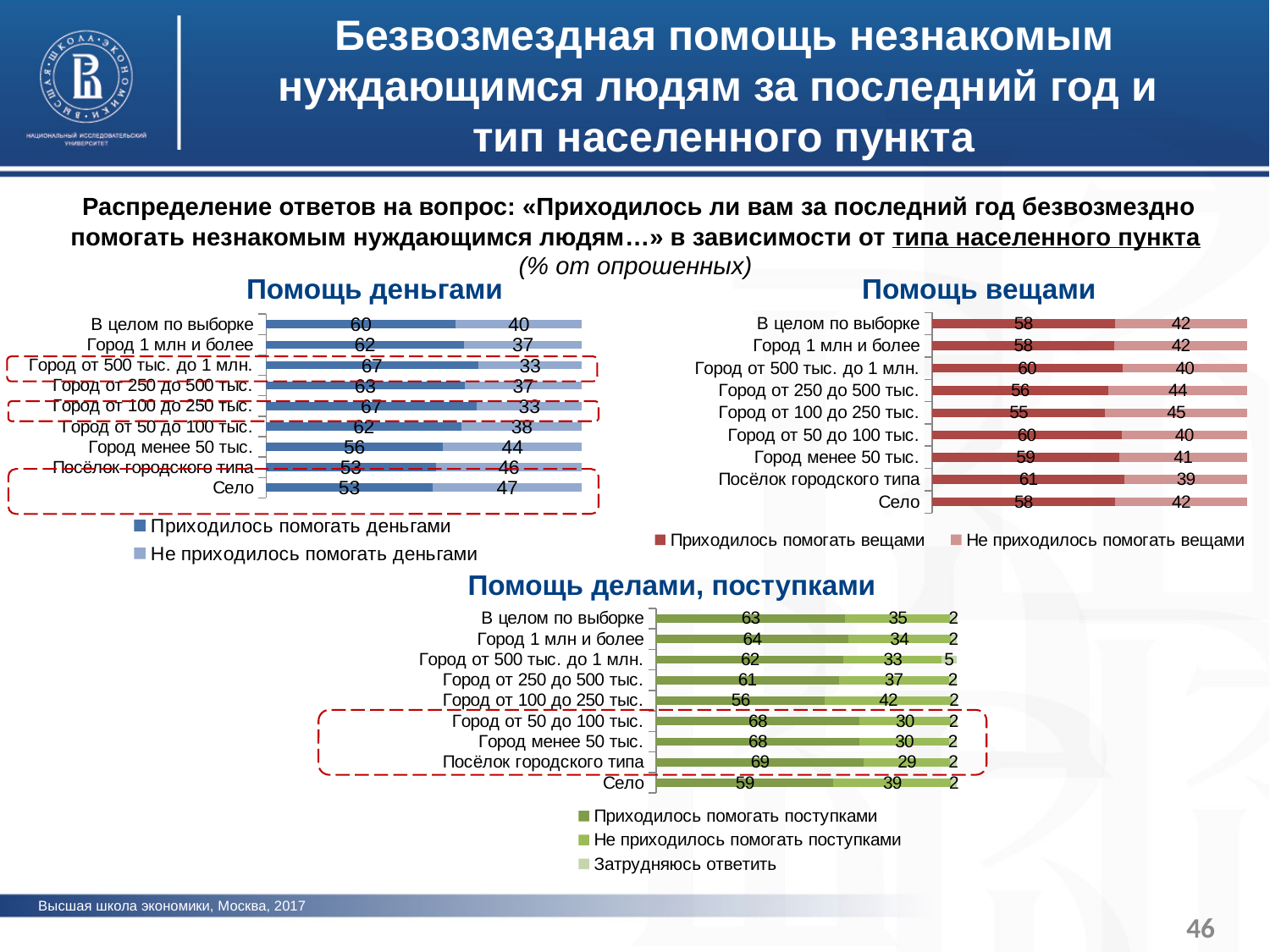
How many series does the legend of the 'Помощь делами, поступками' chart list? 3 In the 'Помощь вещами' chart, what colour represents 'Приходилось помогать вещами'? Dark red What type of chart is the 'Помощь деньгами' chart? Stacked bar chart In the 'Помощь деньгами' chart, which has the larger value for 'Приходилось помогать деньгами': 'Город менее 50 тыс.' or 'Город от 250 до 500 тыс.'? Город от 250 до 500 тыс. In the 'Помощь делами, поступками' chart, which category has the highest value for 'Приходилось помогать поступками'? Посёлок городского типа In the 'Помощь деньгами' chart, what is the difference between 'Приходилось помогать деньгами' and 'Не приходилось помогать деньгами' for 'Город от 500 тыс. до 1 млн.'? 34 In the 'Помощь вещами' chart, which category has the lowest value for 'Приходилось помогать вещами'? Город от 100 до 250 тыс. In the 'Помощь делами, поступками' chart, what is the value of 'Затрудняюсь ответить' for 'Город от 500 тыс. до 1 млн.'? 5 In the 'Помощь деньгами' chart, what is the value of 'Приходилось помогать деньгами' for 'Село'? 53 In the 'Помощь делами, поступками' chart, what is the total of the stacked bar for 'Город от 100 до 250 тыс.'? 100 In the 'Помощь вещами' chart, what is the value of 'Приходилось помогать вещами' for 'Посёлок городского типа'? 61 How many categories are shown in the 'Помощь вещами' chart? 9